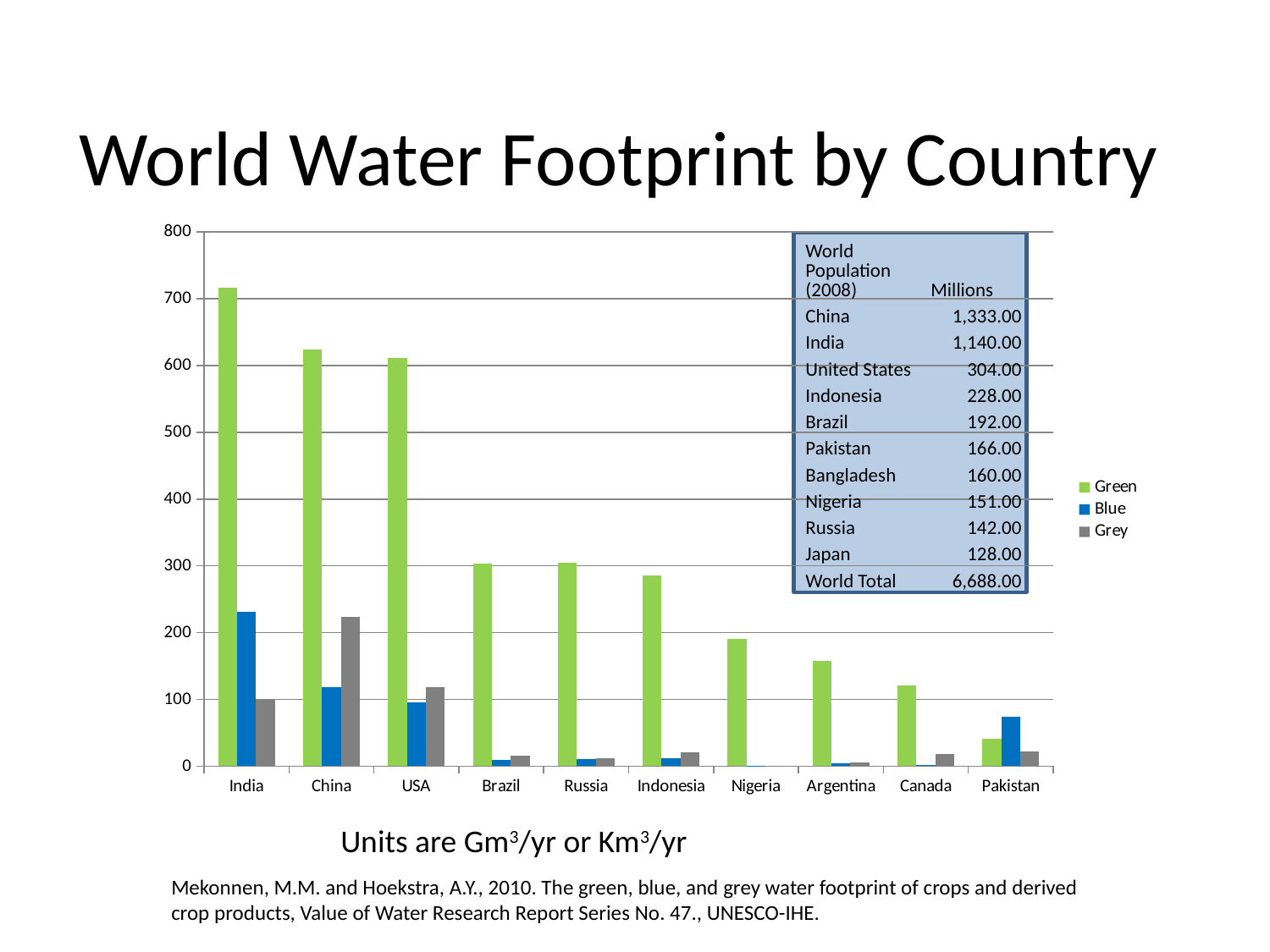
Which country has the highest Blue water footprint bar? India Which country has the highest Green water footprint bar? India For Pakistan, which is larger, the Green bar or the Blue bar? Blue For India, which is larger, the Blue bar or the Grey bar? Blue Is the Green value for Nigeria greater or less than 200? less How many countries are shown on the x axis of the chart? 10 What kind of chart is shown on the slide? bar chart Is the Green value for India greater or less than 700? greater Which country has the highest Grey water footprint bar? China Which country has the lowest Green water footprint bar? Pakistan How many series does the chart's legend list? 3 Do the Green bars generally rise or fall moving from India on the left to Pakistan on the right? fall